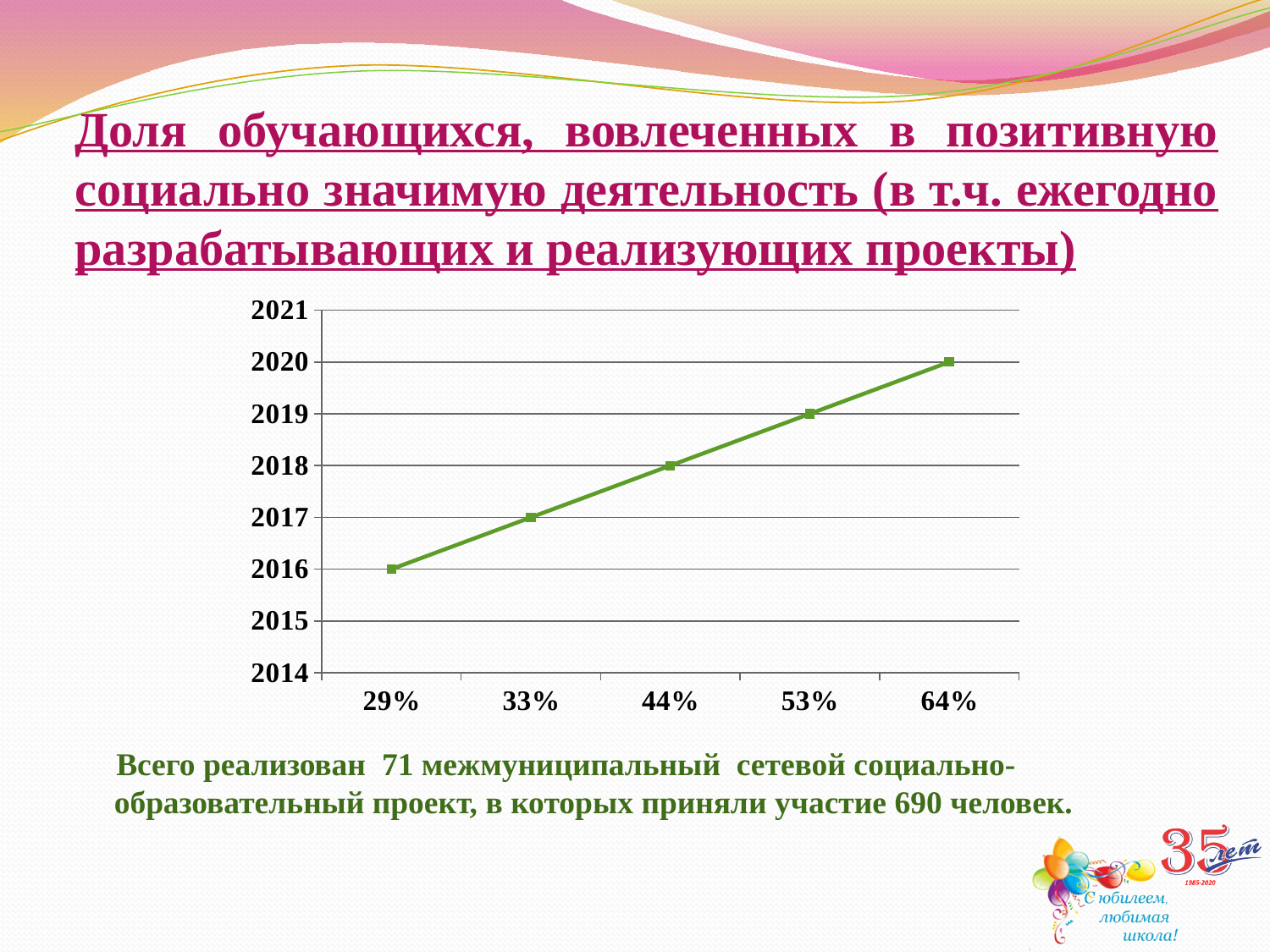
What is the lowest year label shown on the vertical axis? 2014 How many data points are plotted on the line? 5 What year does the point for the 64% category land on? 2020 What year does the point for the 44% category land on? 2018 Which x-axis category has the highest plotted value (latest year)? 64% Which x-axis category has the lowest plotted value (earliest year)? 29% Do the plotted values rise or fall moving left to right along the x axis? rise What year does the point for the 53% category land on? 2019 How many years separate the point for 64% from the point for 29%? 4 Which has the higher plotted value, the point for 33% or the point for 53%? 53% What year does the point for the 29% category land on? 2016 What kind of chart is shown on the slide? line chart